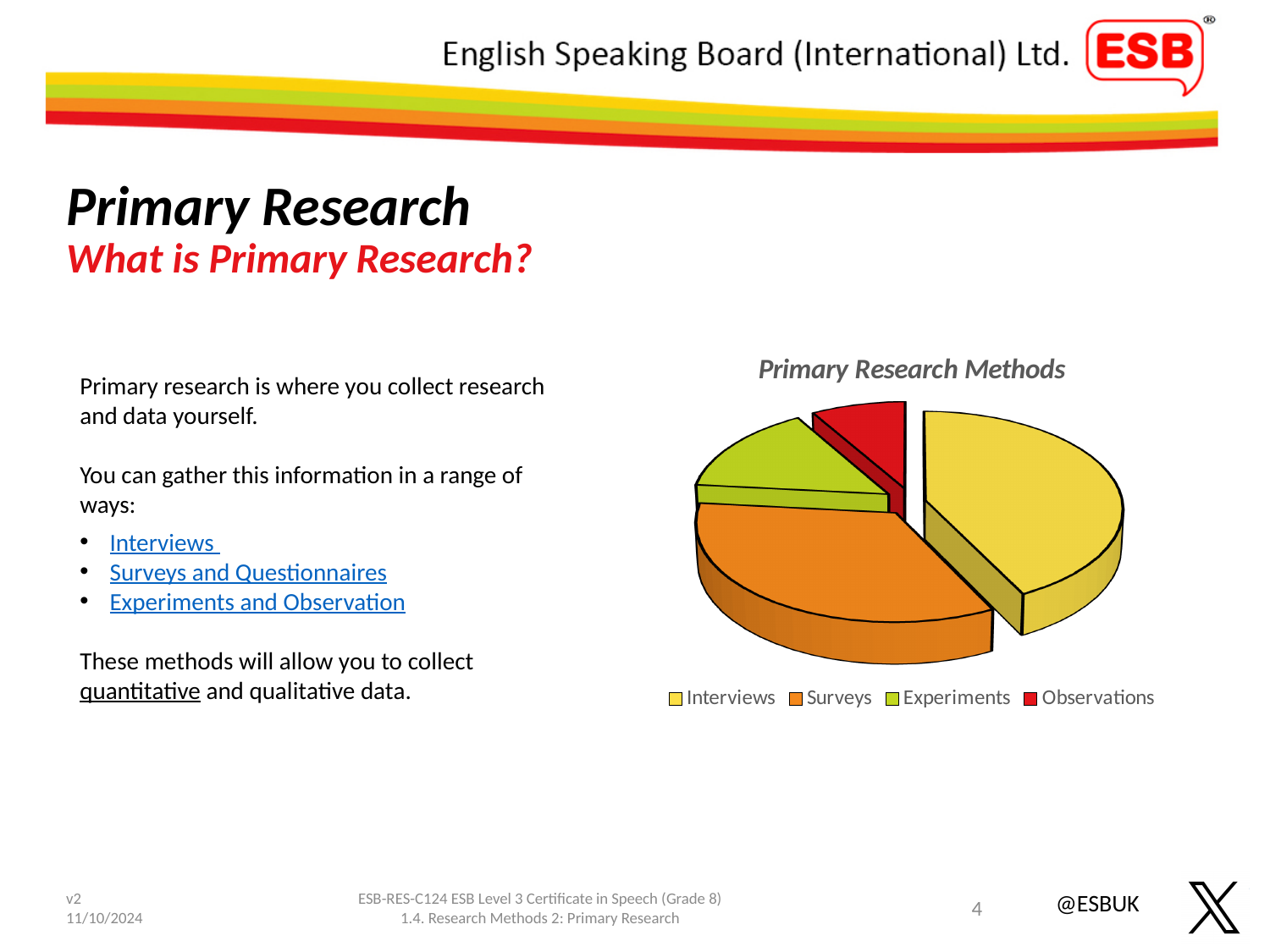
Which slice is larger, Interviews or Observations? Interviews Which category has the smallest slice in the pie chart? Observations What is the title of the chart? Primary Research Methods How many entries does the chart legend list? 4 How many slices does the pie chart have? 4 Which slice is larger, Experiments or Observations? Experiments What kind of chart is shown on the slide? pie chart Which slice is larger, Surveys or Observations? Surveys Which category is shown in red in the pie chart? Observations